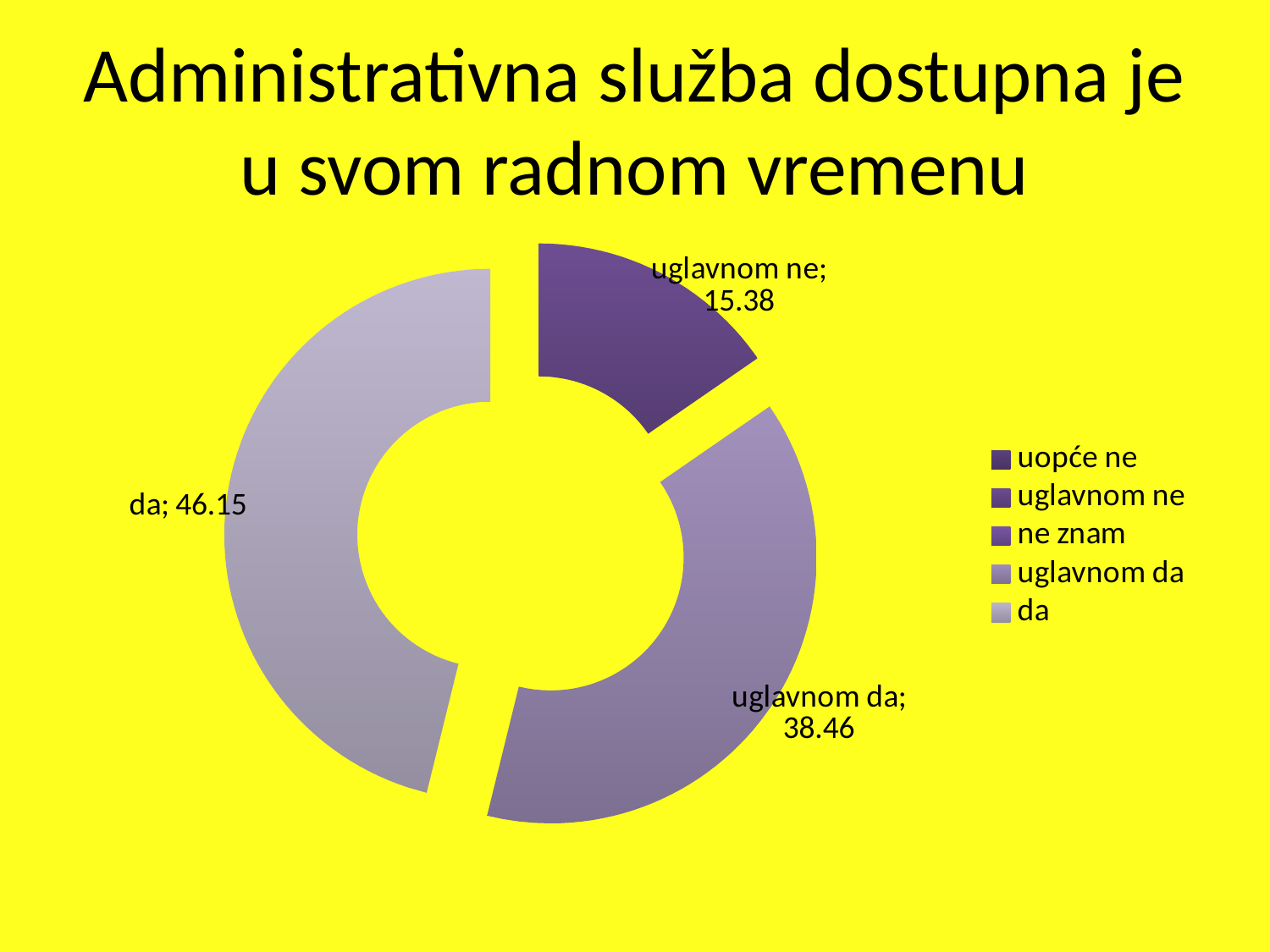
How many slices with data labels are shown in the chart? 3 What is the difference between the values for "da" and "uglavnom da"? 7.69 What is the difference between the values for "uglavnom da" and "uglavnom ne"? 23.08 Which is larger, the value for "uglavnom da" or the value for "uglavnom ne"? uglavnom da What is the value shown for the "uglavnom ne" slice? 15.38 What is the title of the chart on the slide? Administrativna služba dostupna je u svom radnom vremenu Which labelled slice has the smallest value in the chart? uglavnom ne Which category has the largest slice in the chart? da What kind of chart is shown on the slide? doughnut chart How many entries does the legend list? 5 What is the value shown for the "uglavnom da" slice? 38.46 What is the value shown for the "da" slice? 46.15